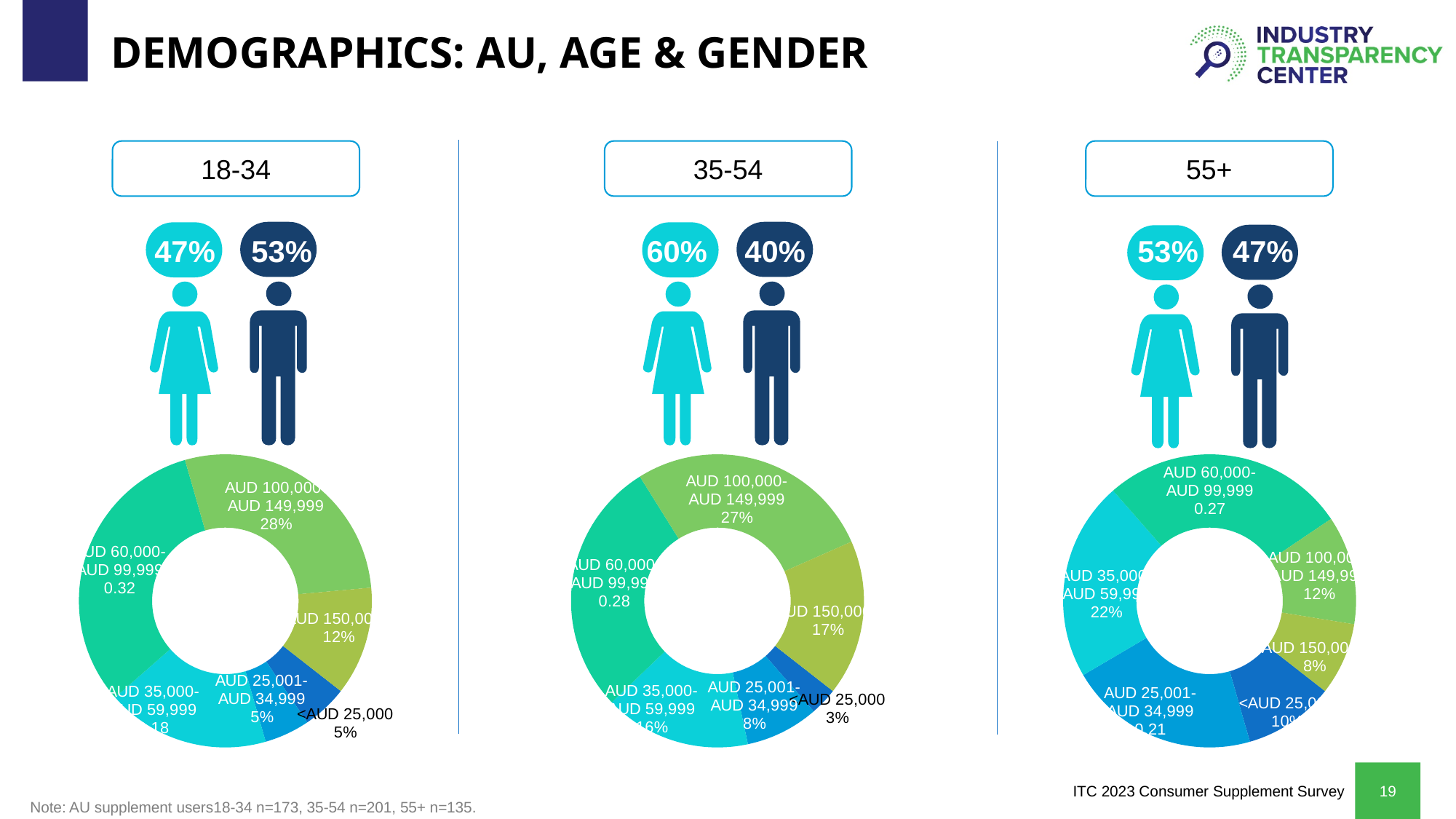
What kind of chart is used for each age group on the slide? doughnut chart In the 18-34 chart, what value is shown for AUD 60,000-AUD 99,999? 0.32 In the 35-54 chart, which income band has the smallest slice? <AUD 25,000 In the 35-54 chart, what share is shown for AUD 25,001-AUD 34,999? 8% In the 18-34 chart, which income band has the largest slice? AUD 60,000-AUD 99,999 In the 55+ chart, which income band has the largest slice? AUD 60,000-AUD 99,999 In the 18-34 chart, what share is shown for AUD 100,000-AUD 149,999? 28% In the 18-34 chart, how many percentage points larger is the AUD 100,000-AUD 149,999 slice (28%) than the AUD 150,000 slice (12%)? 16 In the 35-54 chart, what share is shown for <AUD 25,000? 3% Is the AUD 150,000 slice larger in the 35-54 chart or the 55+ chart? 35-54 How many income-band slices does each doughnut chart contain? 6 In the 55+ chart, what share is shown for AUD 35,000-AUD 59,999? 22%